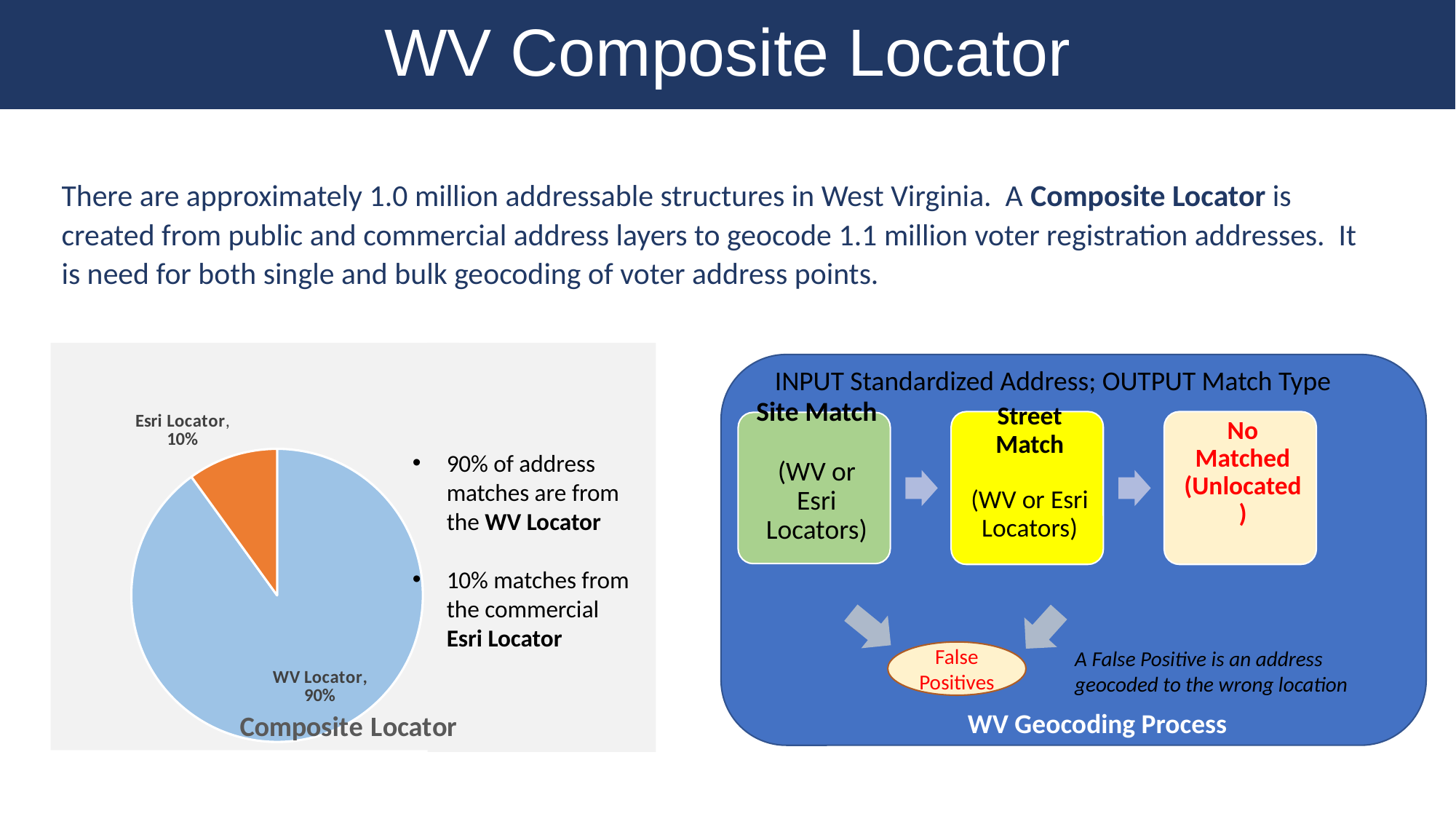
Which slice of the pie chart is the smallest? Esri Locator Which slice of the pie chart is the largest? WV Locator What share of the pie does Esri Locator have? 10% What is the title of the pie chart? Composite Locator What share of the pie does WV Locator have? 90% What kind of chart is shown on the slide? pie chart What colour is the Esri Locator slice in the pie chart? orange Which is larger, the WV Locator slice or the Esri Locator slice? WV Locator What is the difference in percentage points between the WV Locator and Esri Locator slices? 80 How many slices does the pie chart have? 2